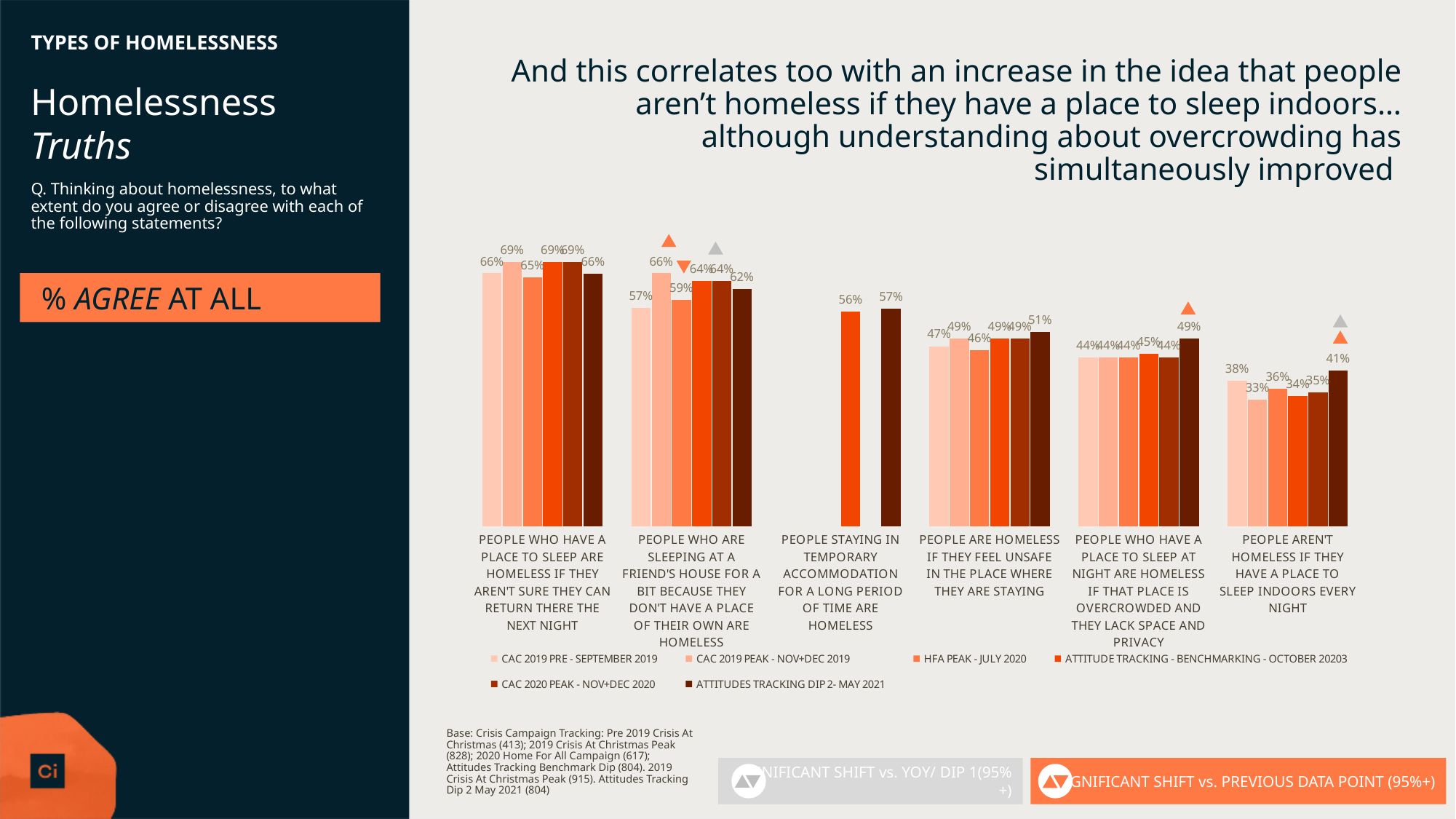
How many series does the chart's legend list? 6 In May 2021, which statement has the higher value: 'People are homeless if they feel unsafe in the place where they are staying' or 'People who have a place to sleep at night are homeless if that place is overcrowded and they lack space and privacy'? People are homeless if they feel unsafe in the place where they are staying For 'People aren't homeless if they have a place to sleep indoors every night', which series has the lowest value? CAC 2019 Peak - Nov+Dec 2019 What is the Attitudes Tracking Dip 2 - May 2021 value for 'People who have a place to sleep at night are homeless if that place is overcrowded and they lack space and privacy'? 49% What is the Attitudes Tracking Dip 2 - May 2021 value for 'People aren't homeless if they have a place to sleep indoors every night'? 41% For 'People aren't homeless if they have a place to sleep indoors every night', which series has the highest value? Attitudes Tracking Dip 2 - May 2021 What is the CAC 2019 Pre - September 2019 value for 'People who are sleeping at a friend's house for a bit because they don't have a place of their own are homeless'? 57% How many bars are plotted for 'People staying in temporary accommodation for a long period of time are homeless'? 2 For 'People aren't homeless if they have a place to sleep indoors every night', what is the difference between the May 2021 value and the CAC 2020 Peak - Nov+Dec 2020 value? 6 percentage points What kind of chart is shown on the slide? bar chart What is the Attitudes Tracking Dip 2 - May 2021 value for 'People staying in temporary accommodation for a long period of time are homeless'? 57% How many statement categories are shown along the x axis of the chart? 6